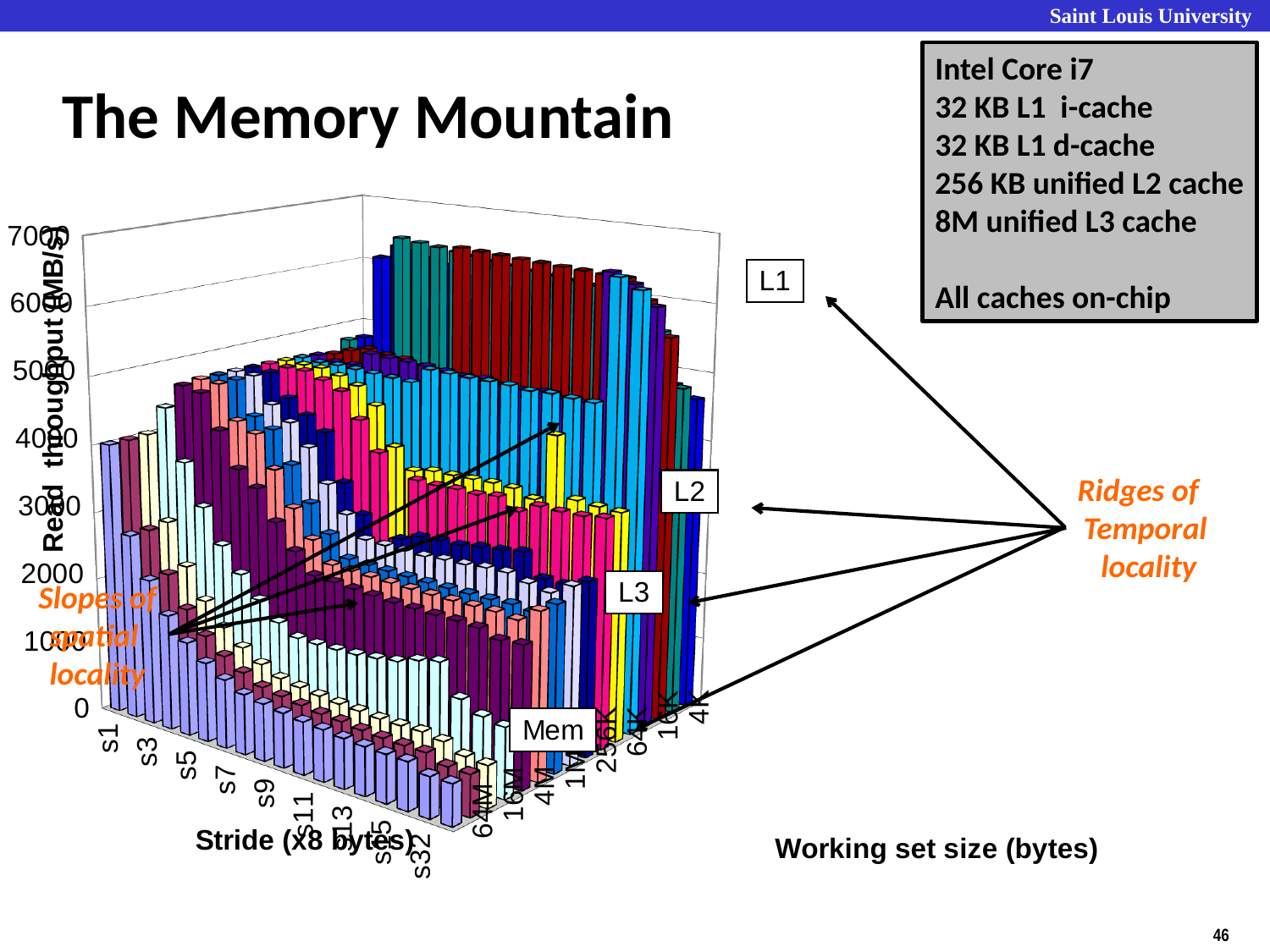
How many stride labels are shown along the stride axis of the chart? 9 Which region of the chart has the highest read throughput: the L1 ridge or the Mem region? L1 ridge What is the label of the vertical axis of the chart? Read throughput (MB/s) Which labelled region of the chart has the lowest read throughput? Mem What kind of chart is shown on the slide? 3D bar chart Is the highest read throughput shown on the chart greater or less than 5000? greater How many working set size labels are shown along the working set size axis of the chart? 8 What is the title of the chart on the slide? The Memory Mountain